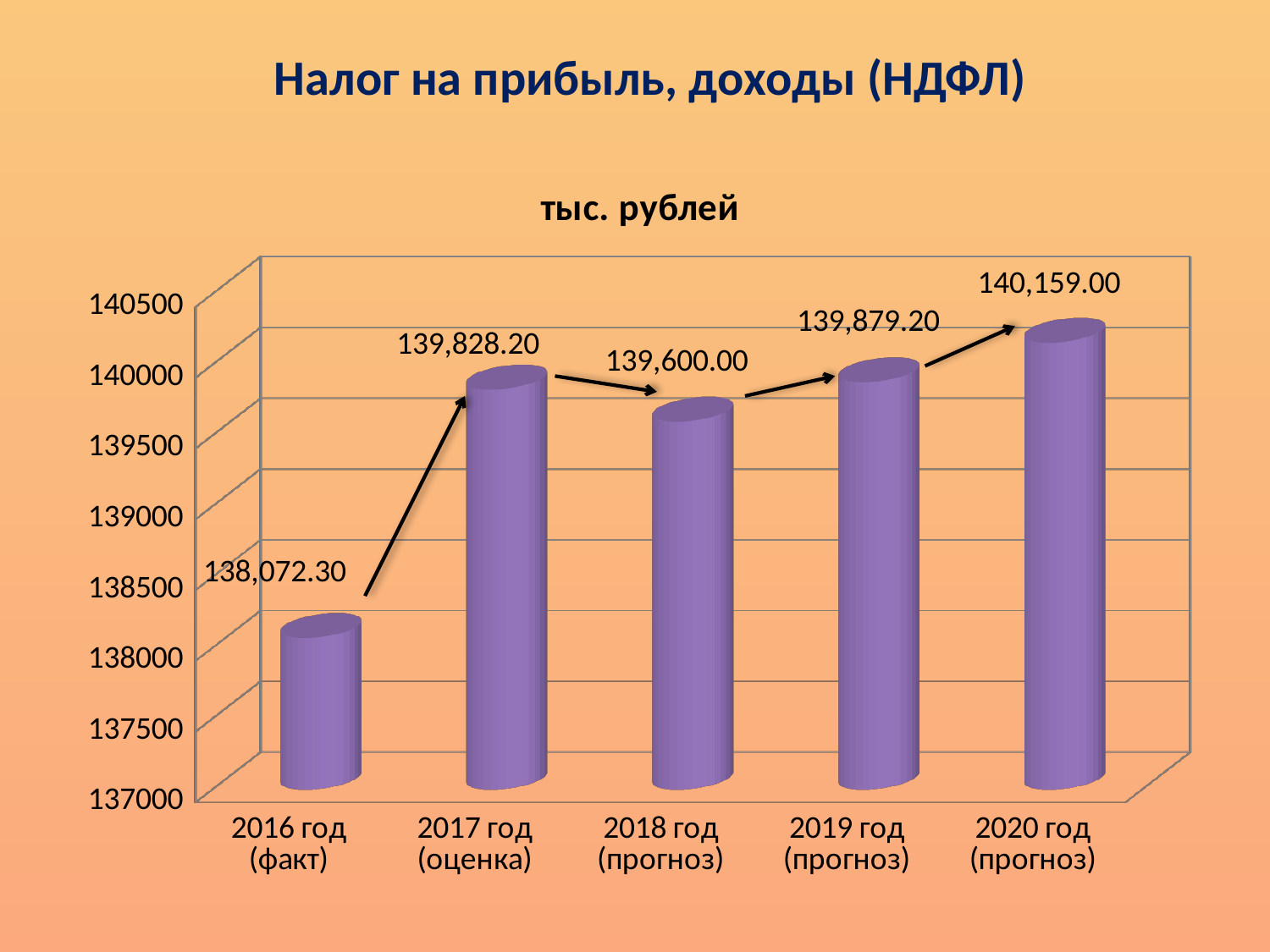
What is the difference between the values for 2017 год (оценка) and 2018 год (прогноз)? 228.20 What is the value for 2016 год (факт)? 138,072.30 How many categories are shown on the x axis? 5 Which category has the highest value? 2020 год (прогноз) Do the values rise or fall from 2018 год (прогноз) to 2020 год (прогноз)? rise Which is larger, the value for 2017 год (оценка) or the value for 2018 год (прогноз)? 2017 год (оценка) What kind of chart is shown on the slide? bar chart What is the difference between the values for 2020 год (прогноз) and 2016 год (факт)? 2,086.70 What is the value for 2018 год (прогноз)? 139,600.00 What is the value for 2020 год (прогноз)? 140,159.00 Is the value for 2016 год (факт) greater or less than 138500? less Which category has the lowest value? 2016 год (факт)